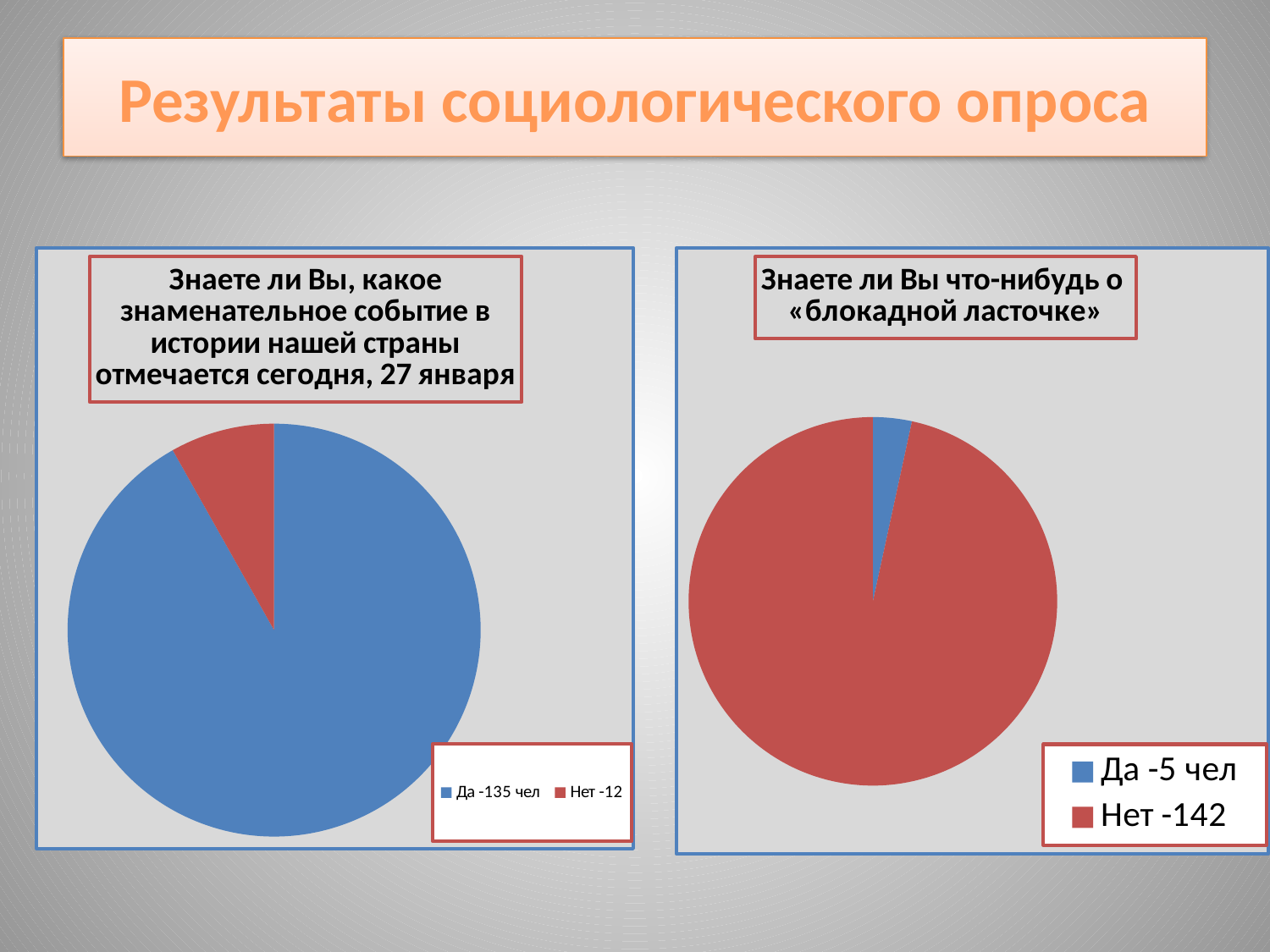
In the left chart (about the event celebrated on 27 January), how many people answered «Нет»? 12 What kind of chart is the left chart on the slide? Pie chart In the left chart (about the event celebrated on 27 January), what is the difference between the number of «Да» and «Нет» answers? 123 In the right chart (about «блокадная ласточка»), how many people answered «Да»? 5 чел In the left chart (about the event celebrated on 27 January), what colour is the «Нет» slice? Red In the right chart (about «блокадная ласточка»), what is the difference between the number of «Нет» and «Да» answers? 137 In the right chart (about «блокадная ласточка»), which answer has the smaller slice? Да In the left chart (about the event celebrated on 27 January), how many people answered «Да»? 135 чел What kind of chart is the right chart on the slide? Pie chart In the left chart (about the event celebrated on 27 January), which answer has the larger slice? Да How many slices does the right chart (about «блокадная ласточка») have? 2 In the right chart (about «блокадная ласточка»), how many people answered «Нет»? 142